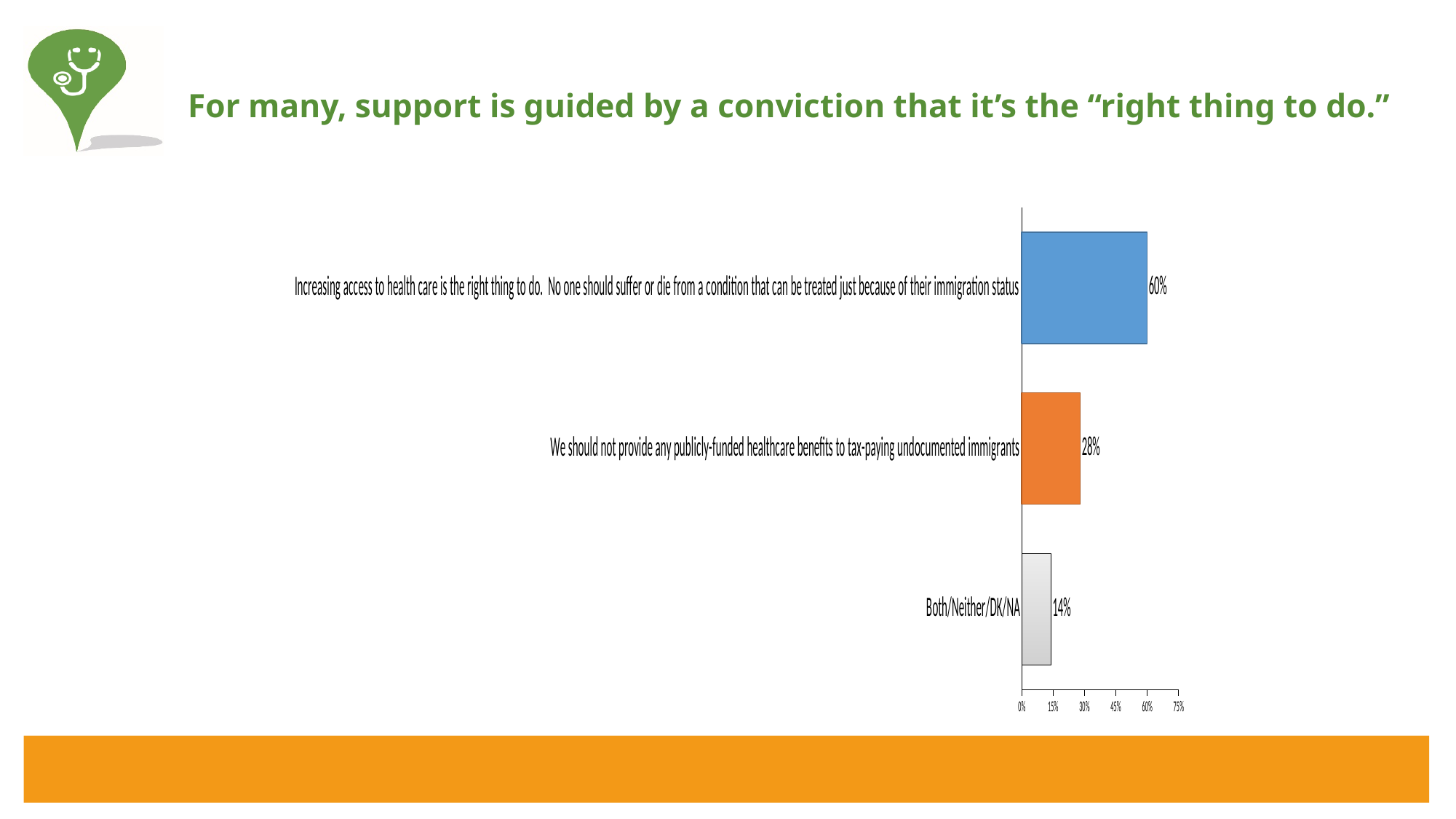
Which is larger: the "should not provide" response or Both/Neither/DK/NA? We should not provide any publicly-funded healthcare benefits to tax-paying undocumented immigrants Which category has the lowest value? Both/Neither/DK/NA What is the difference between the "right thing to do" response and the "should not provide" response? 32 percentage points What percentage of respondents chose "Increasing access to health care is the right thing to do"? 60% What is the value shown for Both/Neither/DK/NA? 14% Is the value for the "should not provide" response greater or less than 30%? less What is the difference between the "should not provide" response and Both/Neither/DK/NA? 14 percentage points How many categories are shown in the chart? 3 What is the maximum value shown on the chart's axis? 75% What percentage of respondents chose "We should not provide any publicly-funded healthcare benefits to tax-paying undocumented immigrants"? 28% What kind of chart is shown on the slide? Bar chart Which category has the highest value? Increasing access to health care is the right thing to do